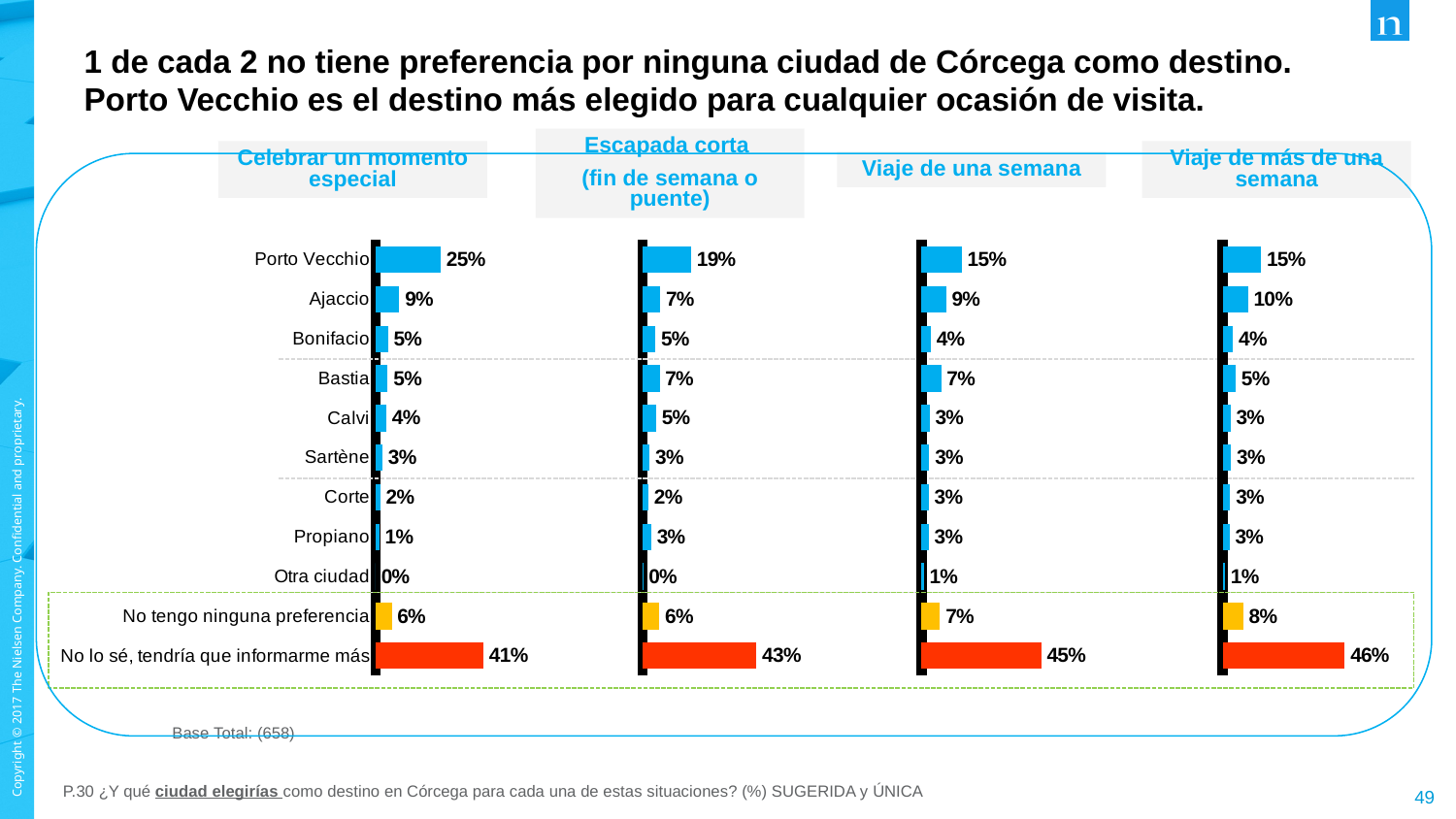
How many charts are shown on the slide? 4 In the 'Viaje de más de una semana' chart, what is the value for Ajaccio? 10% In the 'Viaje de una semana' chart, what is the value for 'No lo sé, tendría que informarme más'? 45% In the 'Escapada corta (fin de semana o puente)' chart, what is the difference between 'No lo sé, tendría que informarme más' and Porto Vecchio? 24% In the 'Escapada corta (fin de semana o puente)' chart, what is the value for Bastia? 7% In the 'Viaje de más de una semana' chart, which category has the highest value? No lo sé, tendría que informarme más What type of chart is used for 'Viaje de una semana'? Bar chart Which is larger: Porto Vecchio in the 'Celebrar un momento especial' chart or Porto Vecchio in the 'Escapada corta (fin de semana o puente)' chart? Celebrar un momento especial In the 'Celebrar un momento especial' chart, which category has the lowest value? Otra ciudad In the 'Celebrar un momento especial' chart, what is the difference between Porto Vecchio and Ajaccio? 16% How many categories are shown in the 'Viaje de una semana' chart? 11 In the 'Celebrar un momento especial' chart, what is the value for Porto Vecchio? 25%